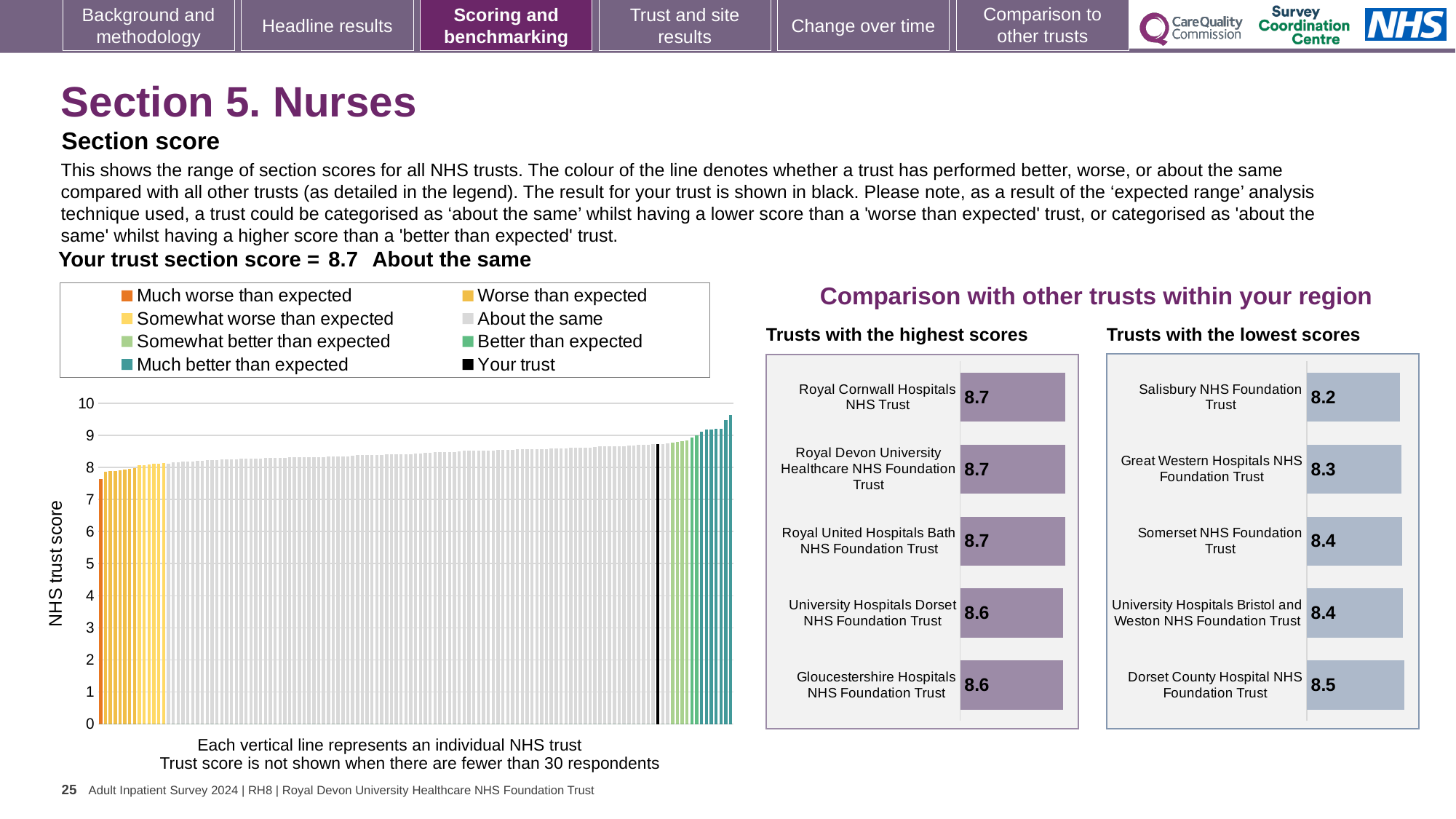
In the 'Trusts with the highest scores' chart, what is the score for Royal Cornwall Hospitals NHS Trust? 8.7 In the 'Trusts with the highest scores' chart, what is the score for Gloucestershire Hospitals NHS Foundation Trust? 8.6 How many entries does the legend of the main NHS trust score chart list? 8 In the main NHS trust score chart, is the value of the leftmost (lowest) bar greater or less than 8? less How many trusts are listed in the 'Trusts with the highest scores' chart? 5 In the 'Trusts with the lowest scores' chart, which has the higher score: Great Western Hospitals NHS Foundation Trust or Somerset NHS Foundation Trust? Somerset NHS Foundation Trust In the 'Trusts with the lowest scores' chart, what is the score for Great Western Hospitals NHS Foundation Trust? 8.3 In the main NHS trust score chart, do the bar values rise or fall from left to right? Rise In the 'Trusts with the lowest scores' chart, which trust has the lowest score? Salisbury NHS Foundation Trust In the 'Trusts with the lowest scores' chart, which trust has the highest score? Dorset County Hospital NHS Foundation Trust What kind of chart is the main chart showing the range of section scores for all NHS trusts? Bar chart In the 'Trusts with the lowest scores' chart, what is the difference between the scores of Dorset County Hospital NHS Foundation Trust and Salisbury NHS Foundation Trust? 0.3